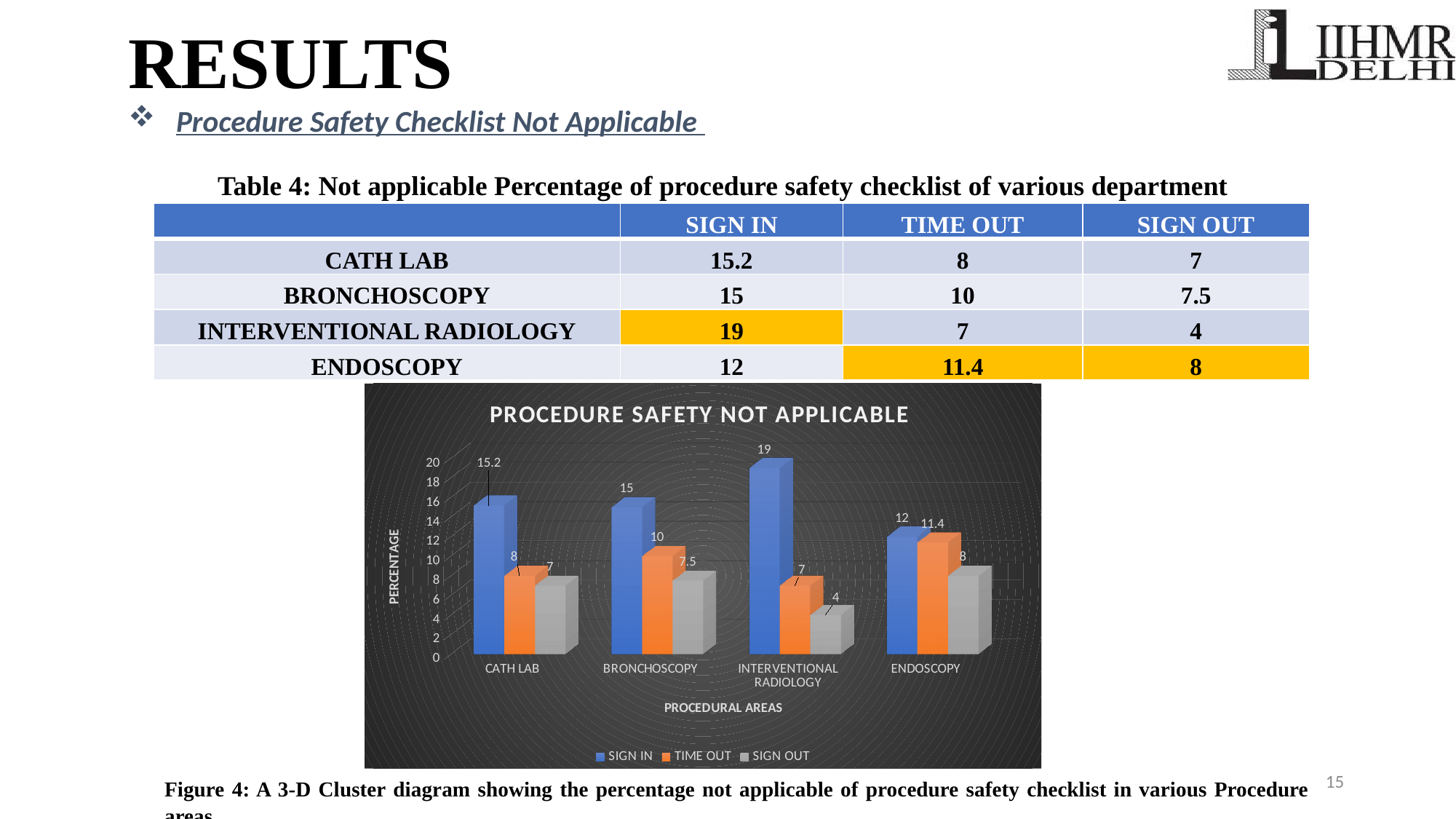
What is the title of the chart? PROCEDURE SAFETY NOT APPLICABLE What kind of chart is shown on the slide? Bar chart Which procedural area has the lowest SIGN OUT value? INTERVENTIONAL RADIOLOGY Which procedural area has the highest SIGN IN value? INTERVENTIONAL RADIOLOGY What is the difference between the SIGN IN value for CATH LAB and the SIGN IN value for ENDOSCOPY? 3.2 How many procedural areas are shown on the x axis of the chart? 4 What is the SIGN IN value for INTERVENTIONAL RADIOLOGY in the chart? 19 What is the label of the vertical axis of the chart? PERCENTAGE Which is larger, the TIME OUT value for BRONCHOSCOPY or the TIME OUT value for CATH LAB? BRONCHOSCOPY What is the SIGN OUT value for BRONCHOSCOPY in the chart? 7.5 What is the TIME OUT value for ENDOSCOPY in the chart? 11.4 How many series does the chart legend list? 3